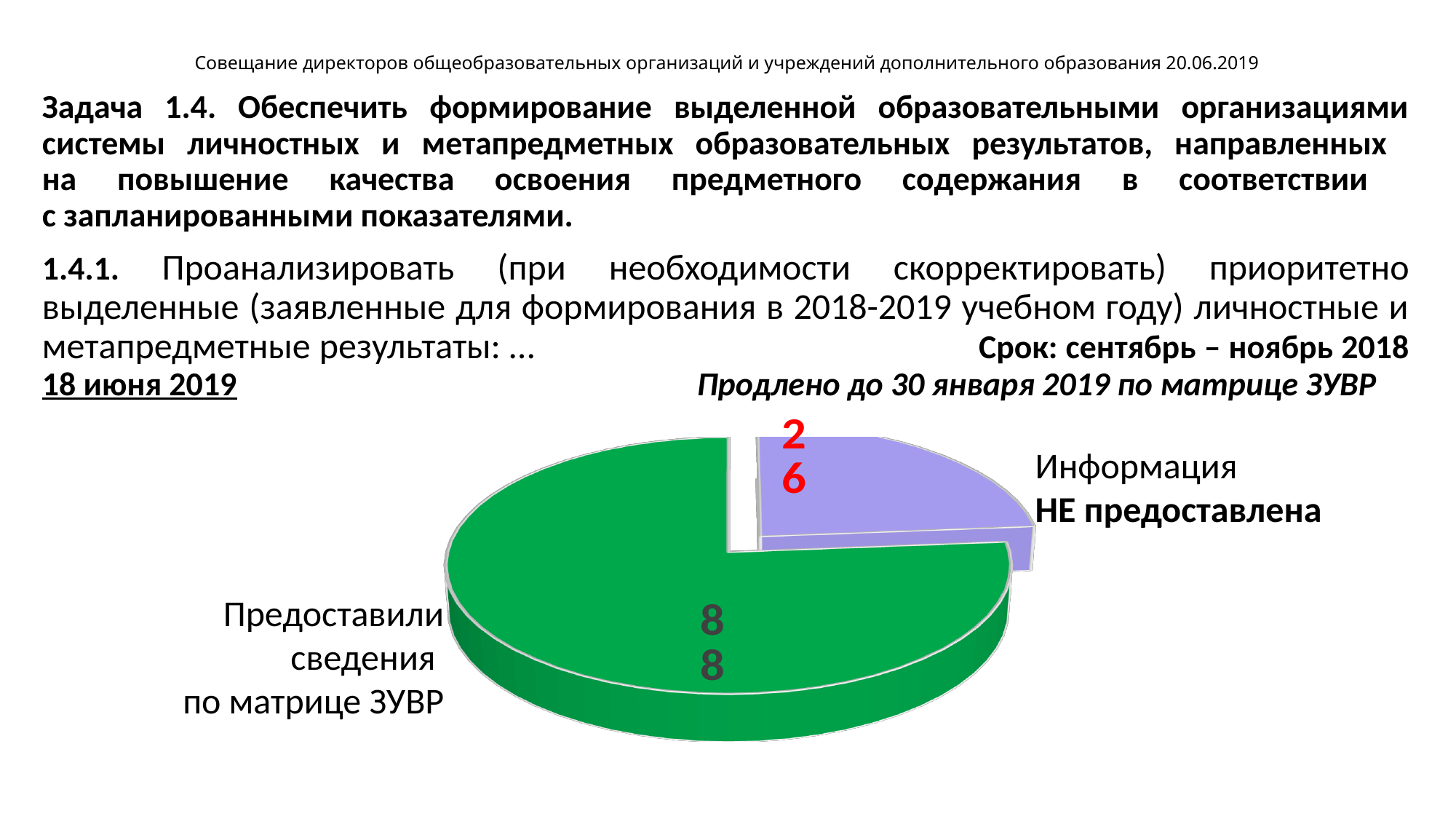
Which is larger: the value for "Предоставили сведения по матрице ЗУВР" or the value for "Информация НЕ предоставлена"? Предоставили сведения по матрице ЗУВР What is the value for "Предоставили сведения по матрице ЗУВР"? 88 What kind of chart is shown on the slide? pie chart What colour is the slice for "Информация НЕ предоставлена"? purple Which slice of the pie chart is the smallest? Информация НЕ предоставлена What is the difference between the value for "Предоставили сведения по матрице ЗУВР" and the value for "Информация НЕ предоставлена"? 62 What colour is the slice for "Предоставили сведения по матрице ЗУВР"? green Which slice of the pie chart is the largest? Предоставили сведения по матрице ЗУВР How many slices does the pie chart have? 2 What is the value for "Информация НЕ предоставлена"? 26 What is the total of the two values shown in the pie chart? 114